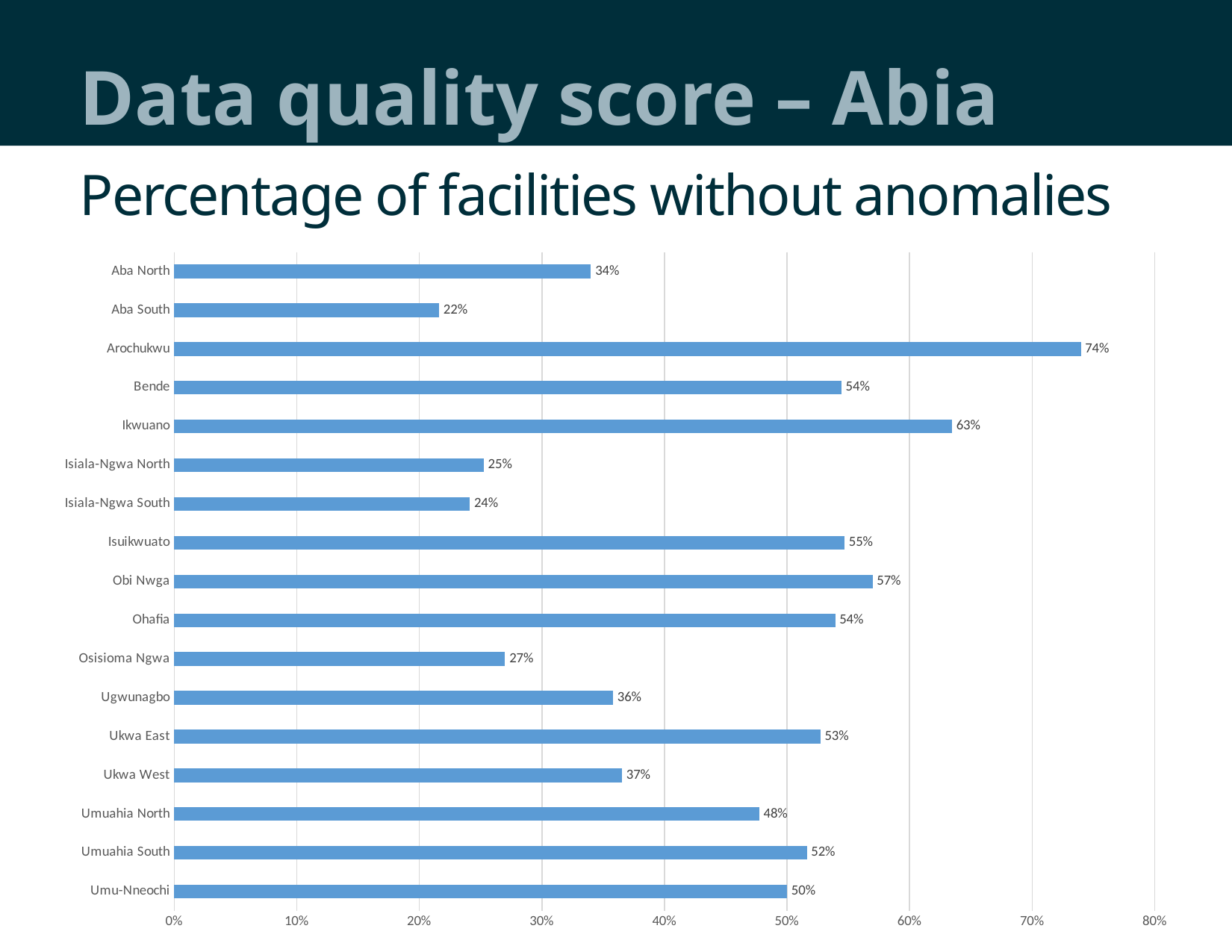
Which local government area has the lowest percentage of facilities without anomalies? Aba South What is the subtitle of the chart on the slide? Percentage of facilities without anomalies How many local government areas are shown in the chart? 17 What is the difference between the values for Aba North and Aba South? 12% Which has a higher value, Obi Nwga or Ukwa East? Obi Nwga What kind of chart is shown on the slide? Bar chart What is the percentage of facilities without anomalies for Arochukwu? 74% Which local government area has the highest percentage of facilities without anomalies? Arochukwu What is the value shown for Aba South? 22% Is the value for Ugwunagbo greater or less than 40%? less What is the difference between the values for Ikwuano and Isiala-Ngwa North? 38% What is the value shown for Umuahia North? 48%